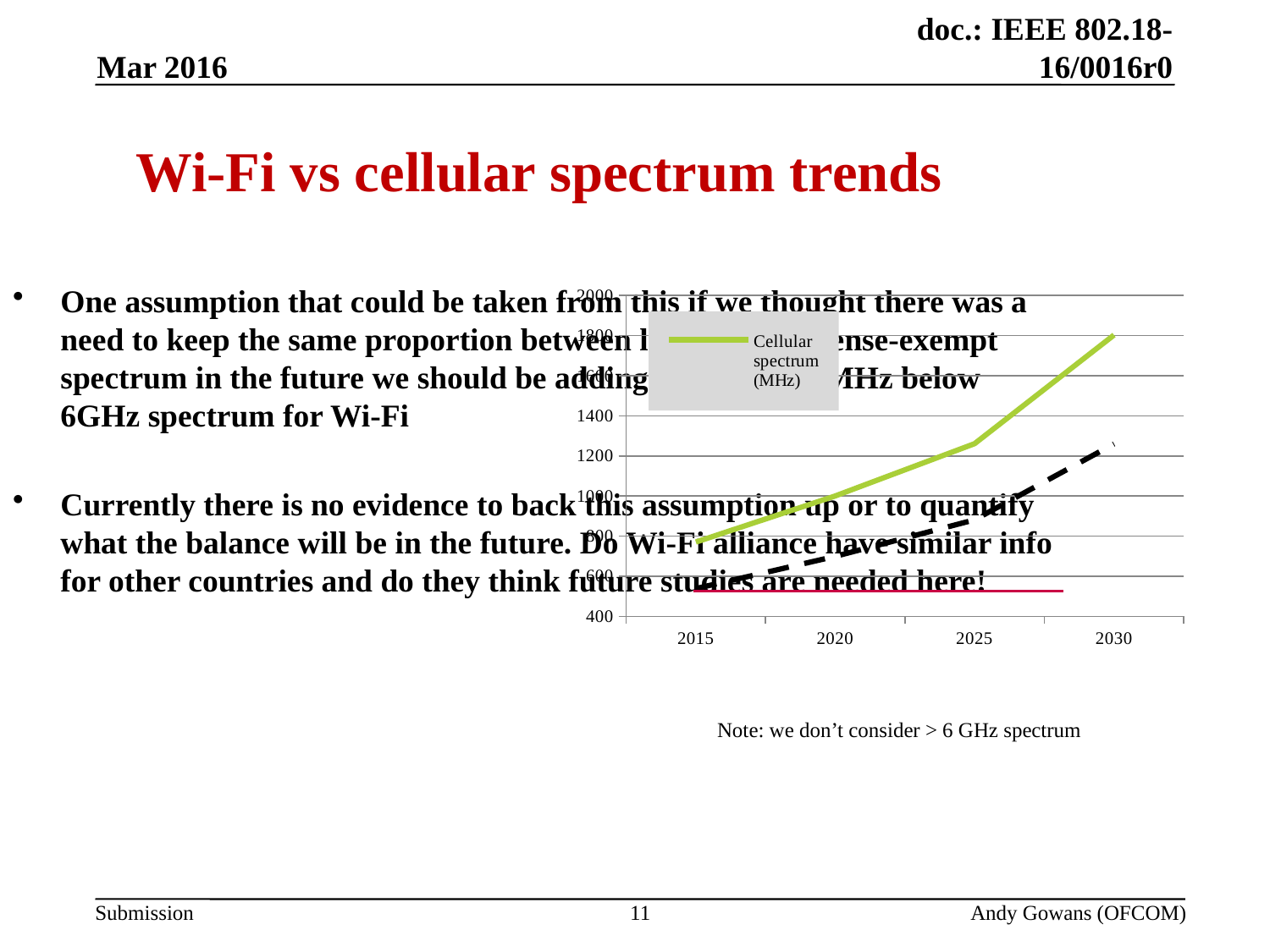
Is the Cellular spectrum (MHz) value for 2030 greater or less than 1600? greater How many years are labelled on the x axis of the chart? 4 In which year is the Cellular spectrum (MHz) value lowest? 2015 Is the Cellular spectrum (MHz) value for 2025 greater or less than 1400? less What colour is the Cellular spectrum (MHz) line? green Does the Cellular spectrum (MHz) line rise or fall from 2015 to 2030? rise Is the Cellular spectrum (MHz) value for 2020 greater or less than 800? greater In which year is the Cellular spectrum (MHz) value highest? 2030 What is the readable legend entry on the chart? Cellular spectrum (MHz) What kind of chart is shown on the slide? line chart